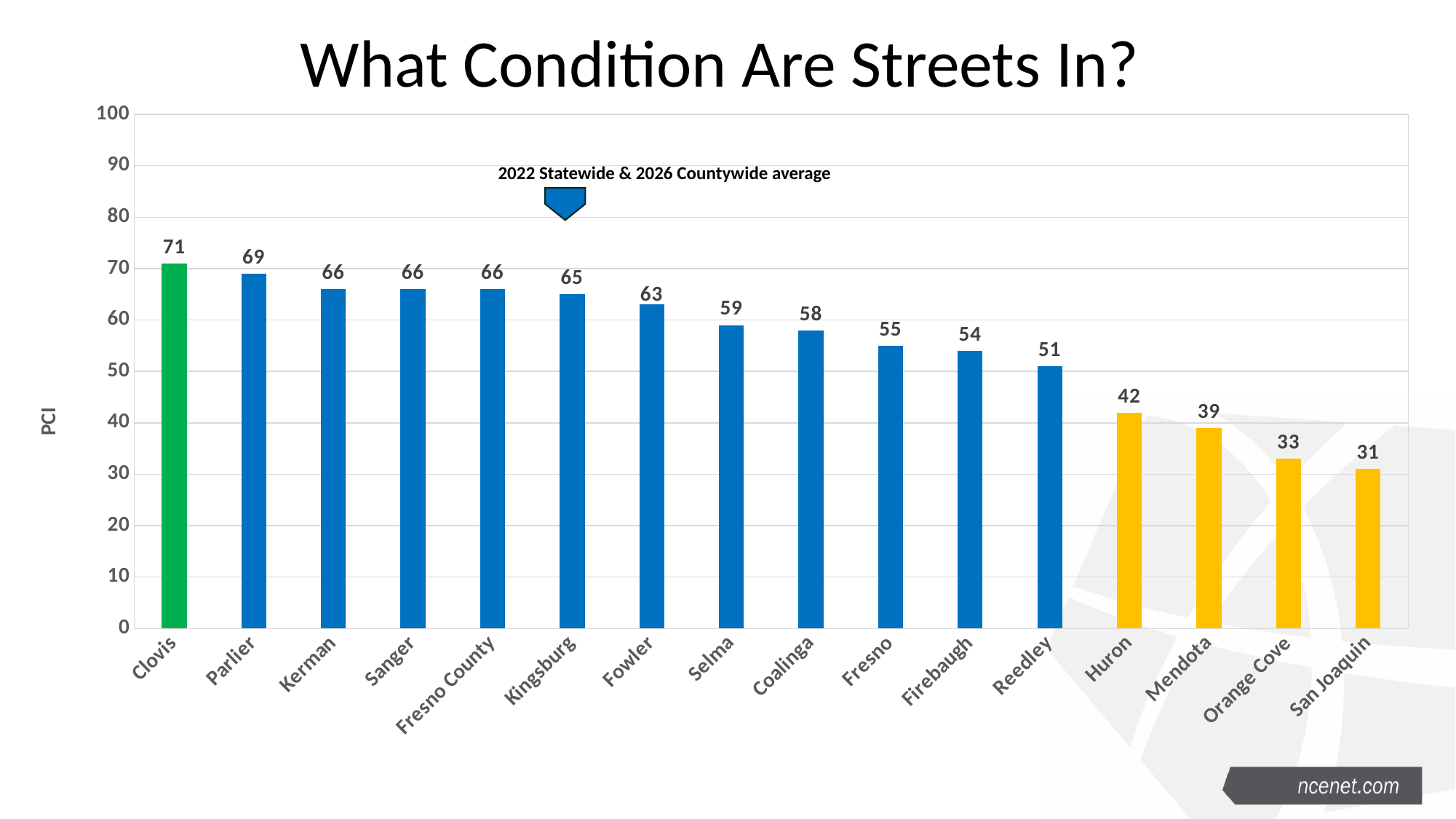
Which has a higher PCI value, Huron or Mendota? Huron Which city has the highest PCI value? Clovis Is the value for Selma greater or less than 50? greater What is the PCI value for Fresno? 55 What is the title of the chart? What Condition Are Streets In? What is the difference between the PCI values for Parlier and Reedley? 18 What kind of chart is shown on the slide? Bar chart Which city has the lowest PCI value? San Joaquin What is the difference between the PCI values for Clovis and San Joaquin? 40 How many cities or categories are shown on the x axis? 16 What is the PCI value for Clovis? 71 What is the PCI value for Orange Cove? 33